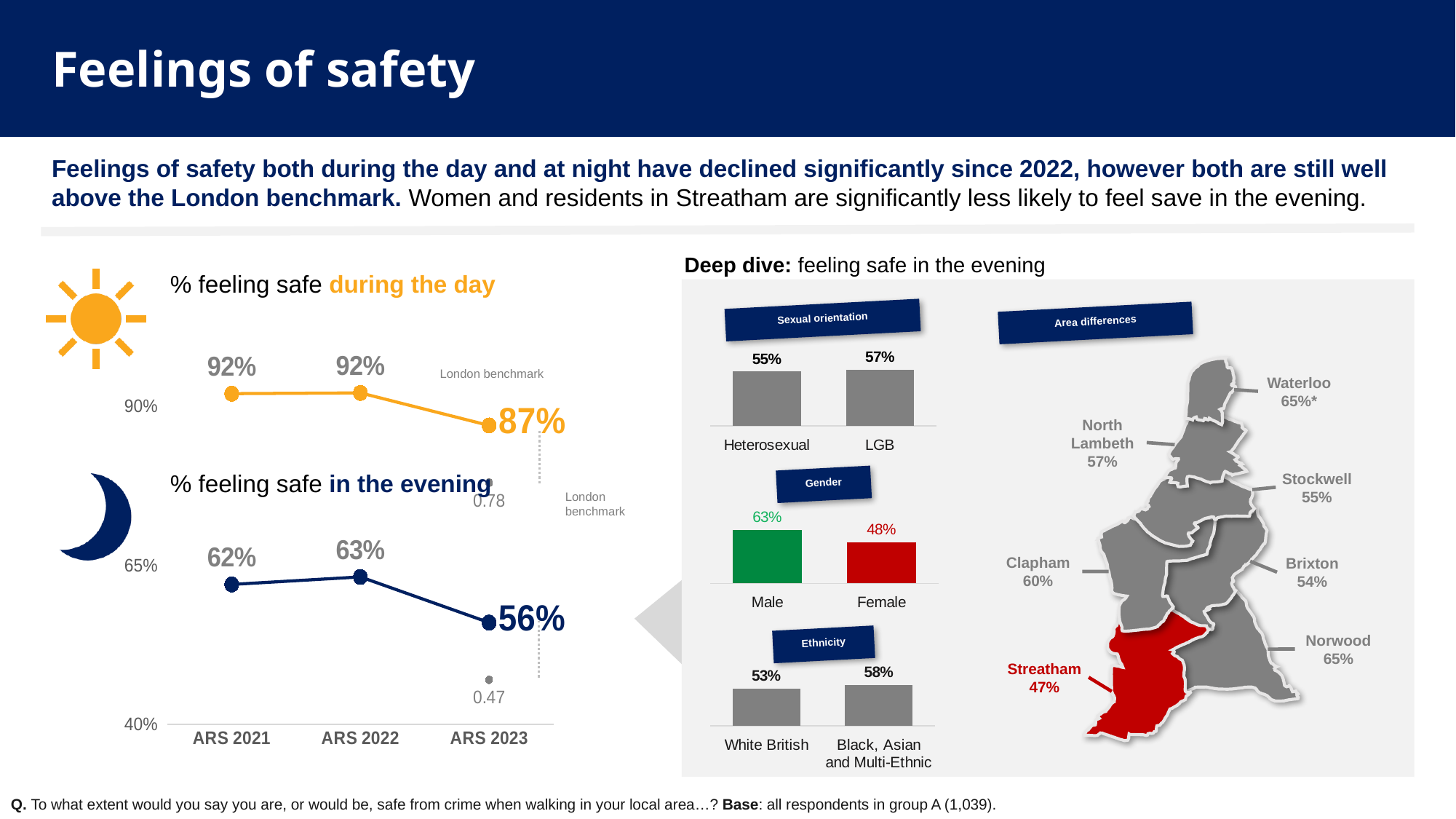
What kind of chart is used for '% feeling safe in the evening'? line chart In the '% feeling safe in the evening' chart, what is the difference between ARS 2022 and ARS 2023? 7 percentage points In the '% feeling safe in the evening' chart, what is the value for ARS 2022? 63% In the '% feeling safe in the evening' chart, which survey year has the lowest value? ARS 2023 In the '% feeling safe during the day' chart, how many survey years are plotted? 3 In the '% feeling safe during the day' chart, what is the value for ARS 2023? 87% In the '% feeling safe during the day' chart, do the values rise or fall from ARS 2022 to ARS 2023? fall On the Area differences map, which area has the lowest value? Streatham In the Gender bar chart, which is larger, Male or Female? Male In the Gender bar chart, what is the value for Female? 48% In the Sexual orientation bar chart, what is the difference between LGB and Heterosexual? 2 percentage points In the Ethnicity bar chart, what is the value for White British? 53%